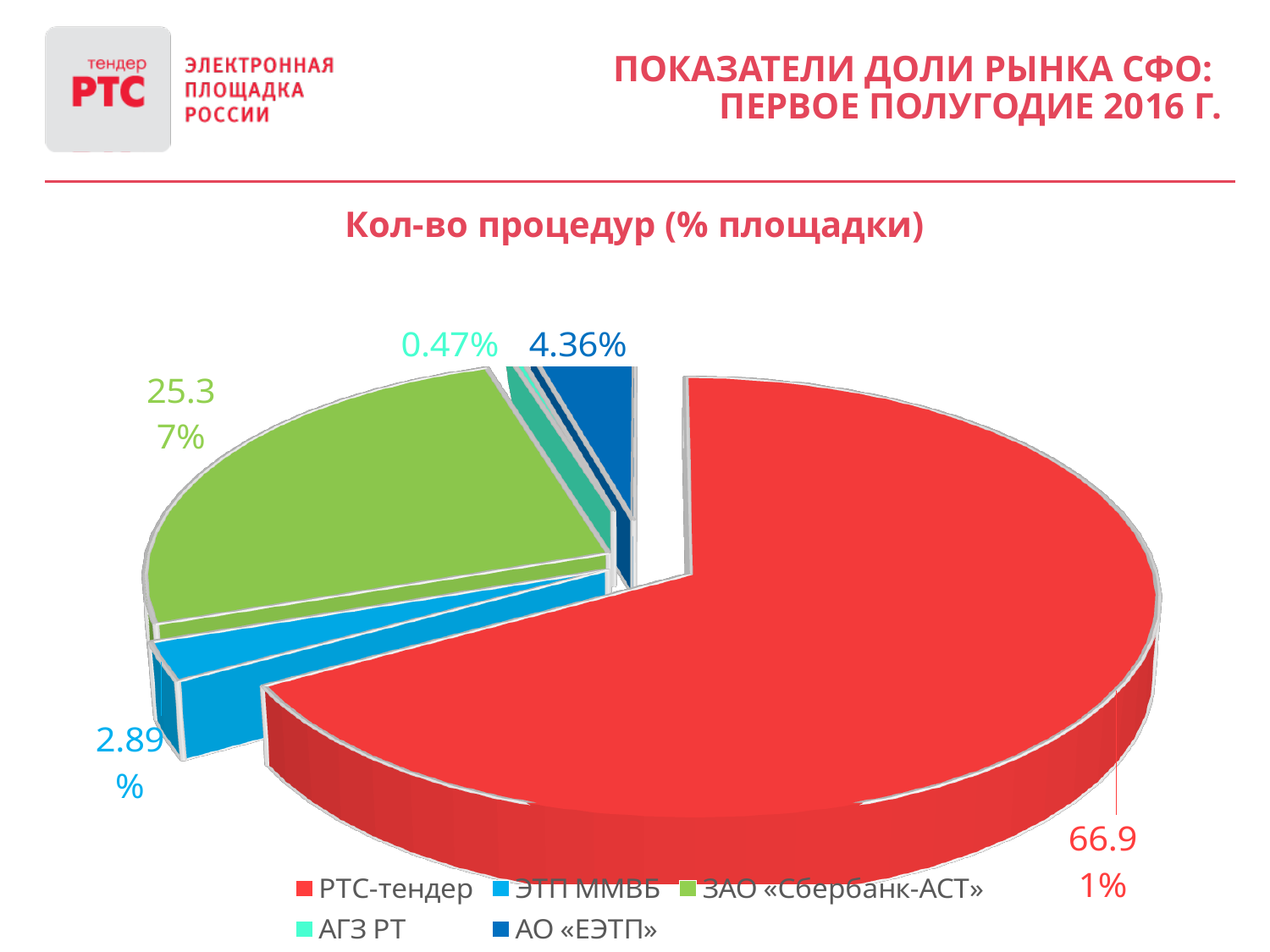
How many entries does the chart legend list? 5 What share of the pie does РТС-тендер have? 66.91% Which platform has the largest share of the pie? РТС-тендер What share of the pie does ЗАО «Сбербанк-АСТ» have? 25.37% Which platform has the smallest share of the pie? АГЗ РТ What is the title of the chart? Кол-во процедур (% площадки) What is the difference between the shares of РТС-тендер and ЗАО «Сбербанк-АСТ»? 41.54% What share of the pie does АО «ЕЭТП» have? 4.36% Which has the larger share, АО «ЕЭТП» or ЭТП ММВБ? АО «ЕЭТП» What share of the pie does АГЗ РТ have? 0.47% What share of the pie does ЭТП ММВБ have? 2.89% What kind of chart is shown on the slide? pie chart